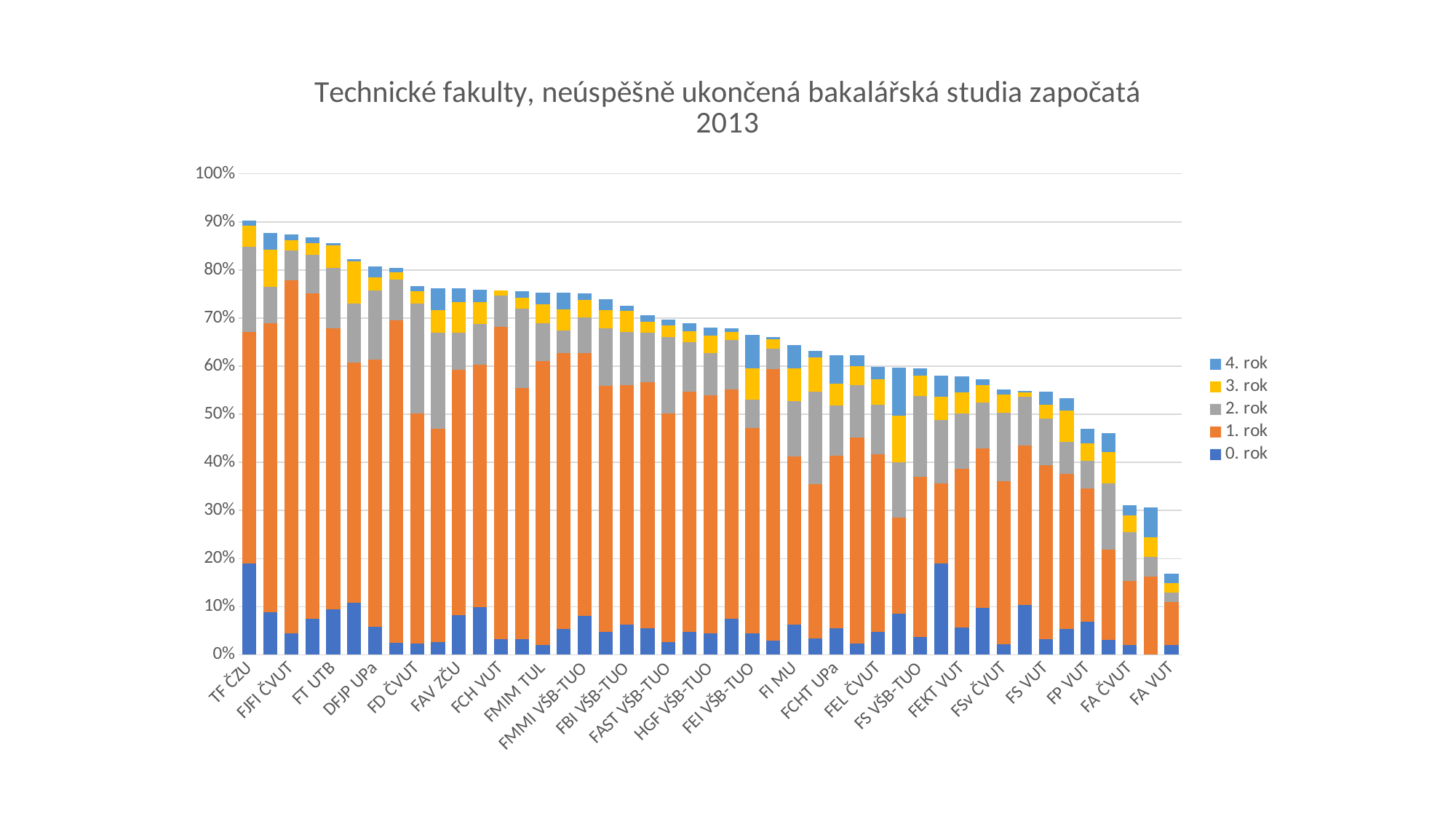
What are the series names listed in the legend? 4. rok, 3. rok, 2. rok, 1. rok, 0. rok Is the 0. rok value for FEKT VUT greater or less than 10%? less What is the title of the chart? Technické fakulty, neúspěšně ukončená bakalářská studia započatá 2013 Is the total stacked value for FA VUT greater or less than 20%? less What kind of chart is shown on the slide? Stacked bar chart Do the total bar heights rise or fall from left to right along the x axis? Fall Which has the larger total stacked bar, TF ČZU or FA VUT? TF ČZU Which labelled faculty has the highest total stacked bar? TF ČZU Is the total stacked value for TF ČZU greater or less than 80%? greater How many series does the legend list? 5 Which labelled faculty has the lowest total stacked bar? FA VUT